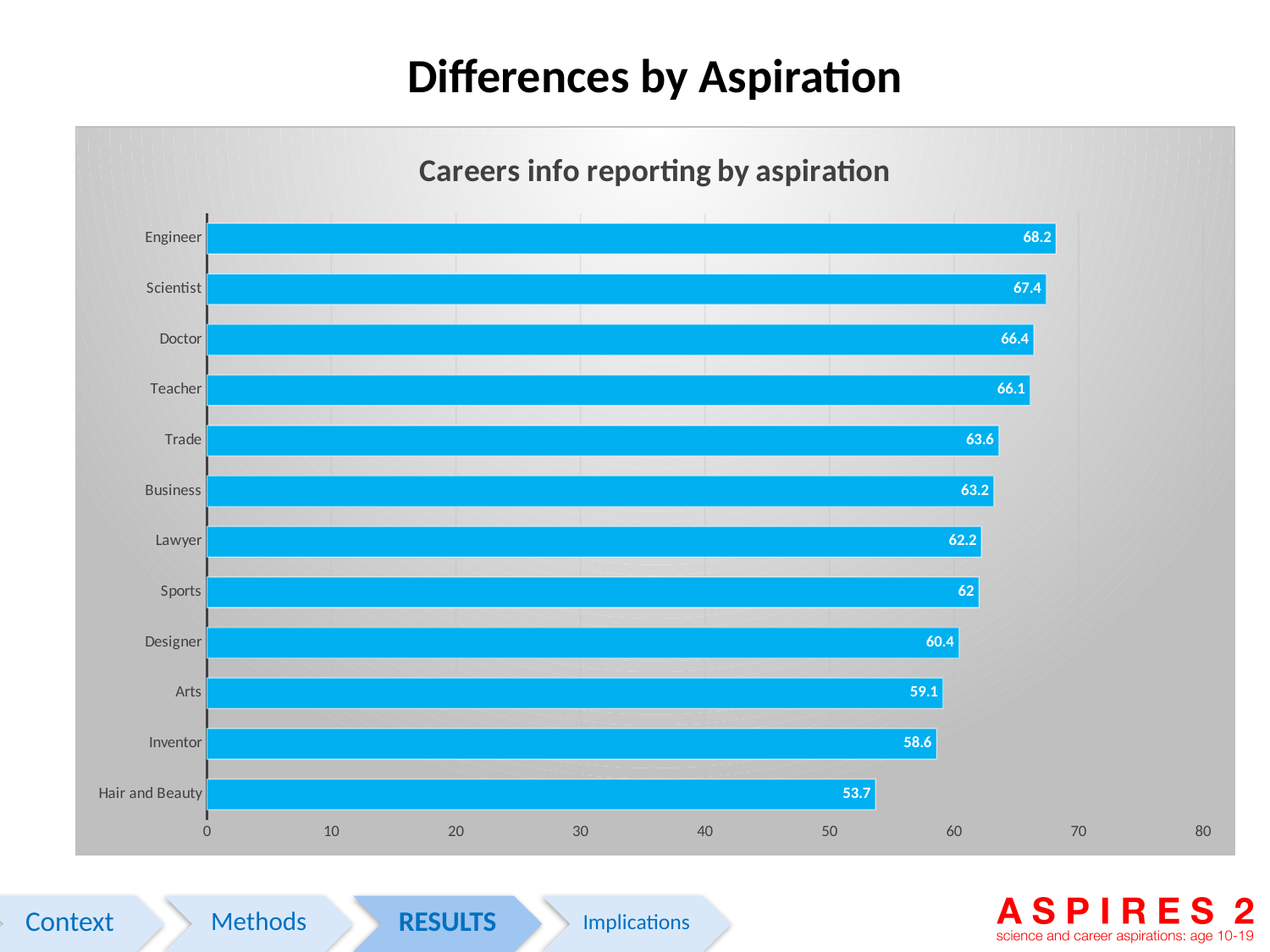
Which category has the lowest value? Hair and Beauty What is the value for Sports? 62 Is the value for Inventor greater or less than 60? less What is the title of the chart? Careers info reporting by aspiration Which is larger, the value for Doctor or the value for Designer? Doctor What is the value for Engineer? 68.2 How many categories are shown in the chart? 12 What kind of chart is shown on the slide? bar chart What is the value for Hair and Beauty? 53.7 Which category has the highest value? Engineer What is the difference between the values for Engineer and Hair and Beauty? 14.5 What is the difference between the values for Scientist and Teacher? 1.3